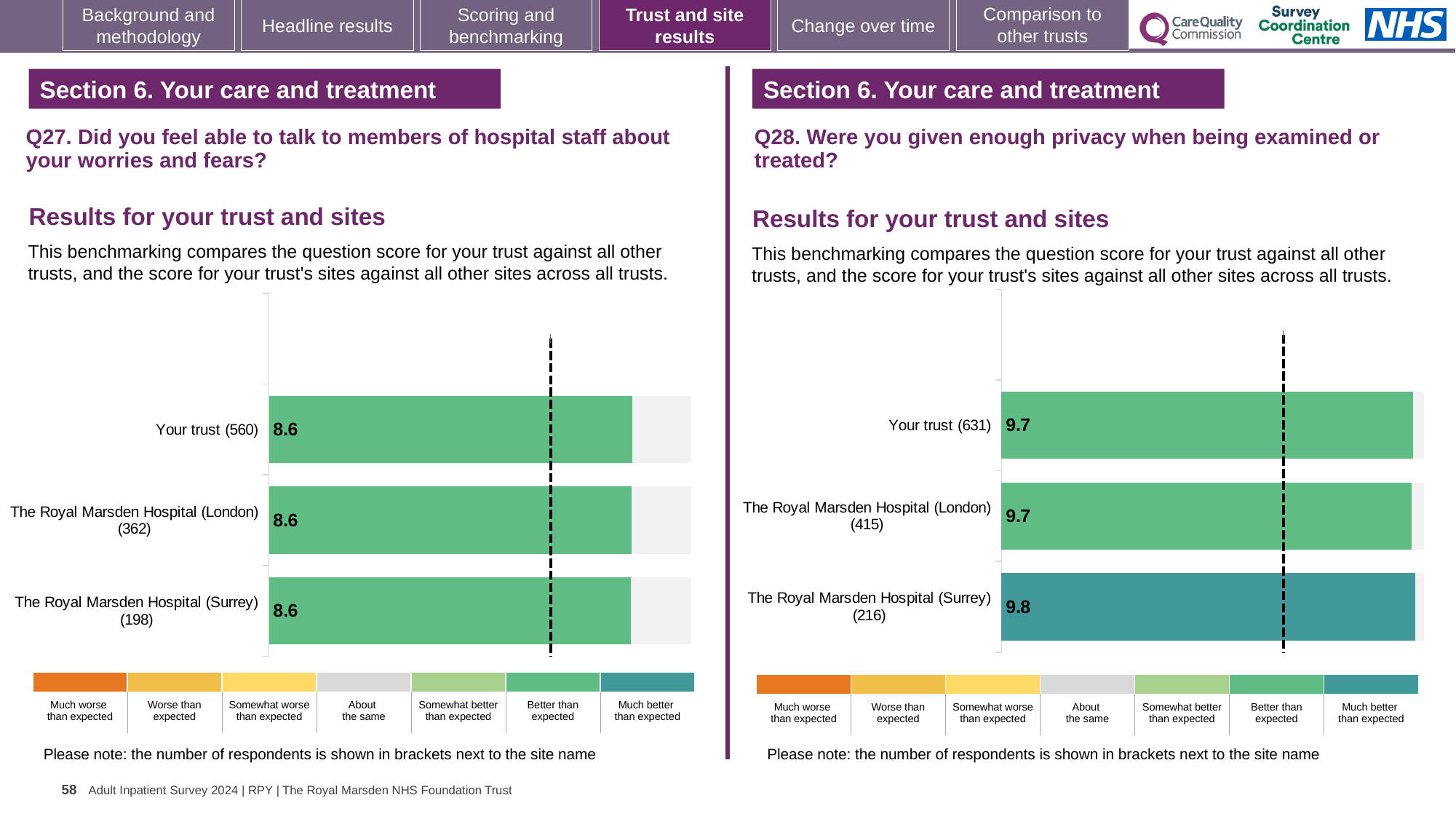
How many bars are plotted in the Q27 chart on the left? 3 In the Q27 chart on the left, how many respondents are shown for Your trust? 560 In the Q28 chart on the right, which benchmark category does the colour of The Royal Marsden Hospital (Surrey) bar correspond to? Much better than expected In the Q28 chart on the right, which has the larger score: Your trust or The Royal Marsden Hospital (Surrey)? The Royal Marsden Hospital (Surrey) In the Q28 chart on the right, which site or trust has the highest score? The Royal Marsden Hospital (Surrey) In the Q28 chart on the right, what is the difference between the scores for The Royal Marsden Hospital (Surrey) and The Royal Marsden Hospital (London)? 0.1 What type of chart is used for the Q28 results on the right? Bar chart In the Q27 chart on the left, which benchmark category does the colour of the Your trust bar correspond to? Better than expected In the Q27 chart on the left, what is the score for The Royal Marsden Hospital (Surrey)? 8.6 In the Q28 chart on the right, what is the score for The Royal Marsden Hospital (London)? 9.7 In the Q28 chart on the right, what is the score for The Royal Marsden Hospital (Surrey)? 9.8 In the Q27 chart on the left, what is the score for Your trust? 8.6